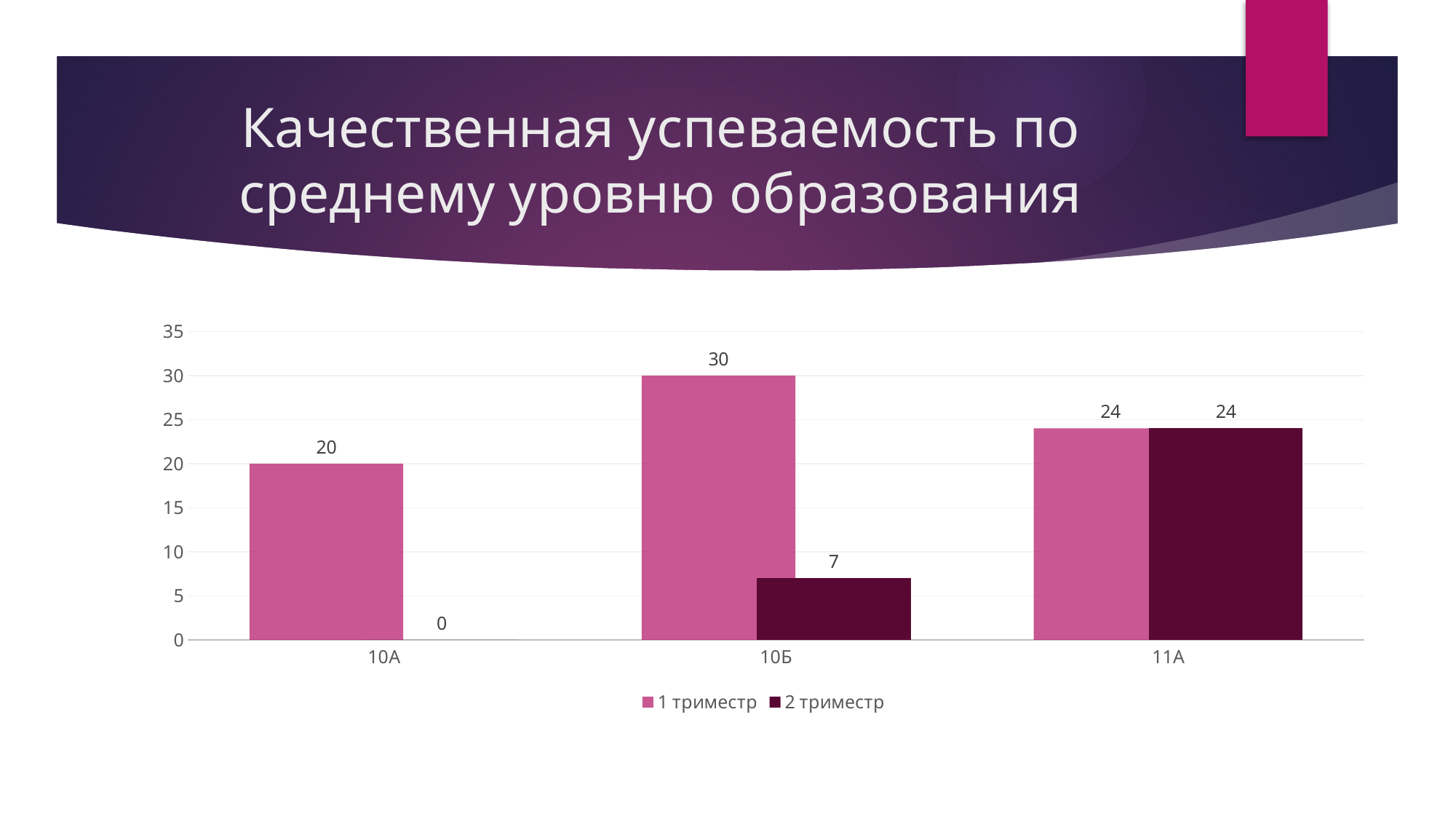
What is the difference between the 1 триместр and 2 триместр values for 10Б? 23 What is the value for 10Б in the 1 триместр series? 30 What kind of chart is shown on the slide? bar chart Which category has the highest value in the 1 триместр series? 10Б What is the value for 11А in the 2 триместр series? 24 What is the title of the slide? Качественная успеваемость по среднему уровню образования How many categories are shown on the x axis? 3 Which category has the lowest value in the 2 триместр series? 10А What is the value for 10Б in the 2 триместр series? 7 How many series does the legend list? 2 What is the value for 10А in the 2 триместр series? 0 Which is larger for 10А: the 1 триместр value or the 2 триместр value? 1 триместр